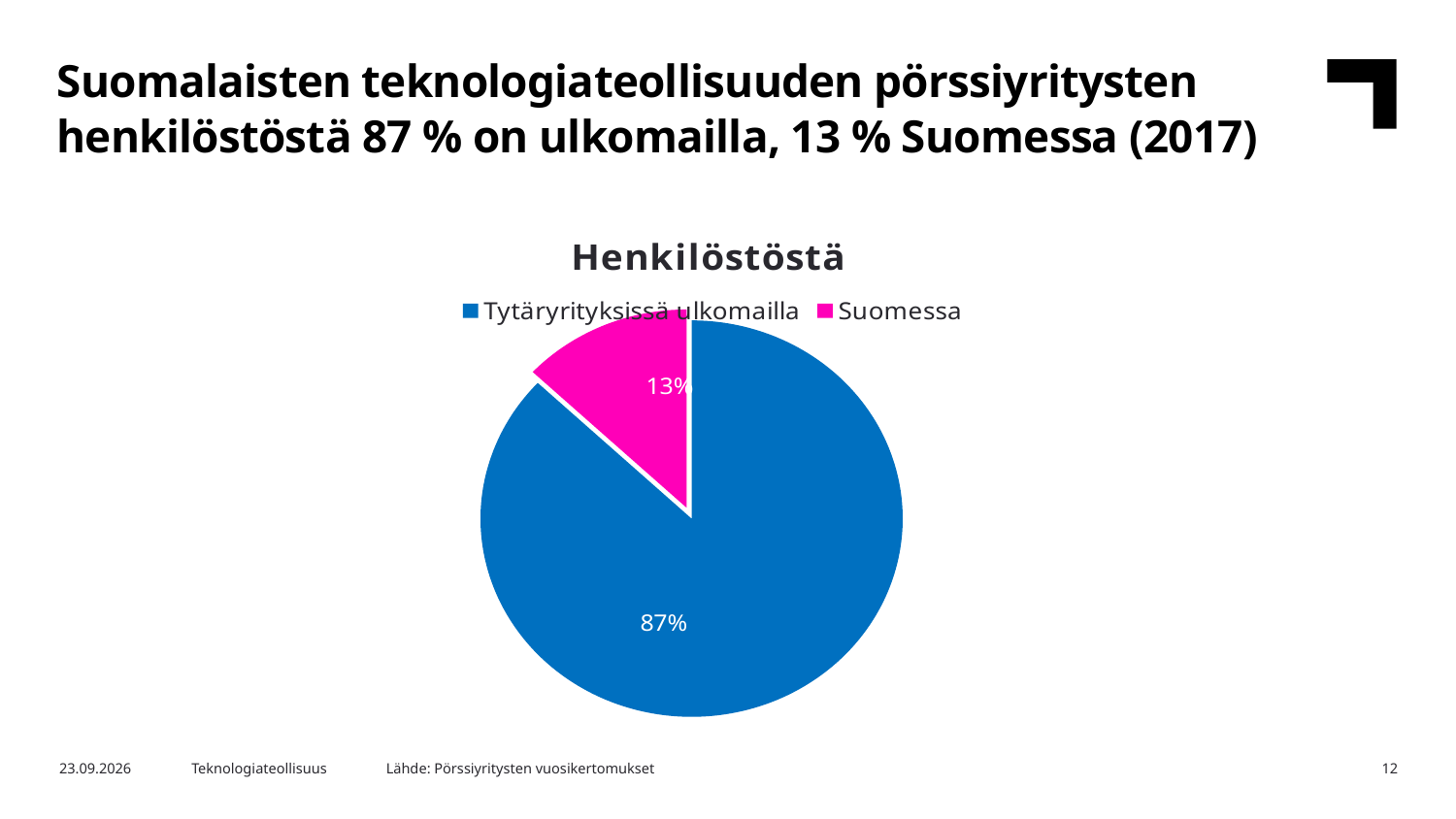
What is the title of the chart? Henkilöstöstä What colour is the Suomessa slice? magenta What share of the pie does Suomessa represent? 13% What is the difference in percentage points between the Tytäryrityksissä ulkomailla slice and the Suomessa slice? 74 How many slices does the pie chart have? 2 What kind of chart is shown on the slide? pie chart Which category has the smallest slice of the pie? Suomessa How many entries does the legend list? 2 Which category has the largest slice of the pie? Tytäryrityksissä ulkomailla Which is larger, the slice for Suomessa or the slice for Tytäryrityksissä ulkomailla? Tytäryrityksissä ulkomailla What share of the pie does Tytäryrityksissä ulkomailla represent? 87%